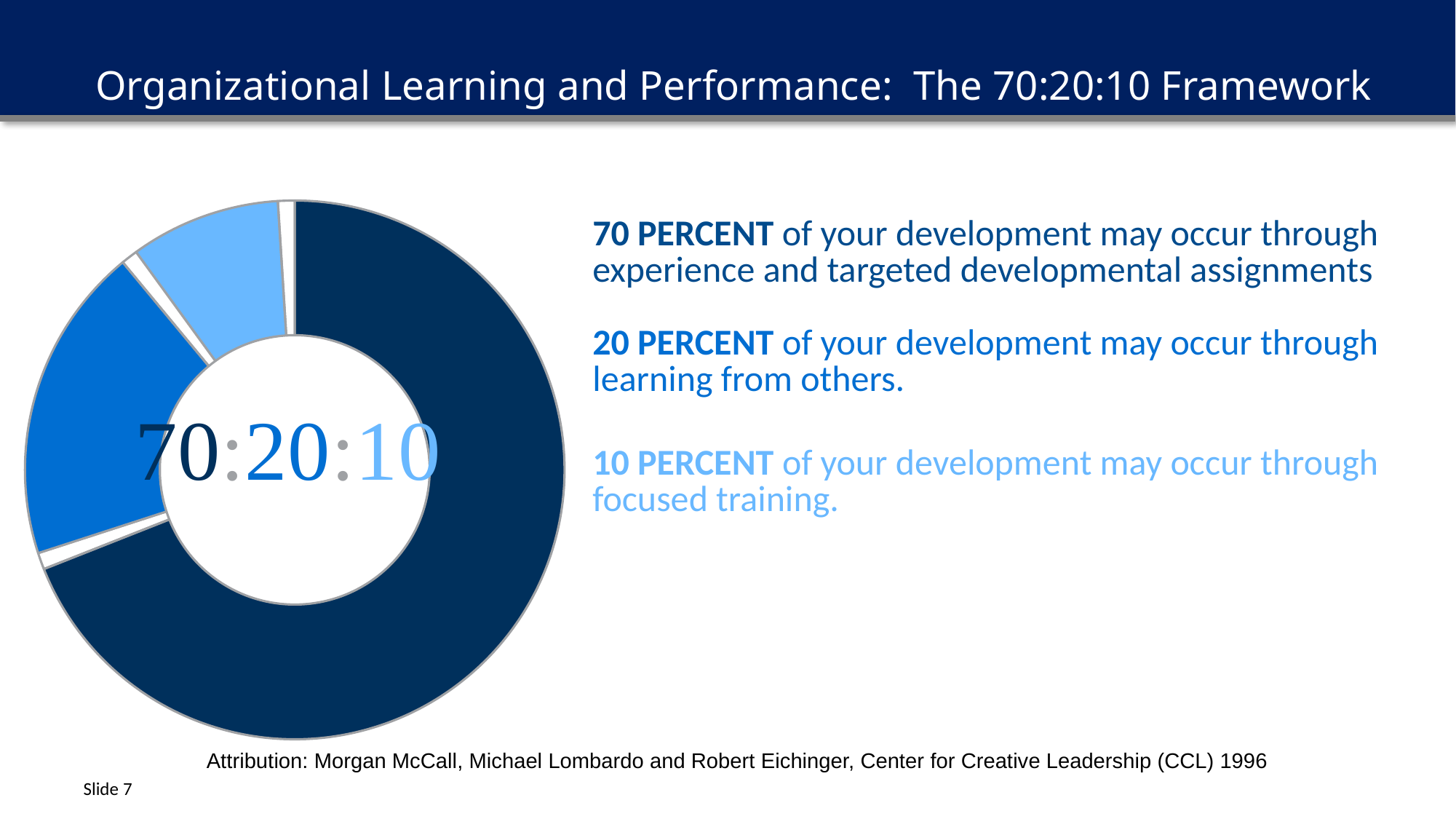
Which source of development has the smallest slice in the chart? focused training What is the difference in percentage points between the learning from others slice and the focused training slice? 10 Which is larger: the slice for learning from others or the slice for focused training? learning from others What kind of chart is shown on the slide? doughnut (pie) chart What share of development does the chart attribute to experience and targeted developmental assignments? 70 percent What share of development does the chart attribute to learning from others? 20 percent What share of development does the chart attribute to focused training? 10 percent What text is printed in the centre of the doughnut chart? 70:20:10 What colour is the slice representing focused training (10 percent)? light blue How many slices does the doughnut chart have? 3 What is the difference in percentage points between the experience slice and the learning from others slice? 50 Which source of development has the largest slice in the chart? experience and targeted developmental assignments